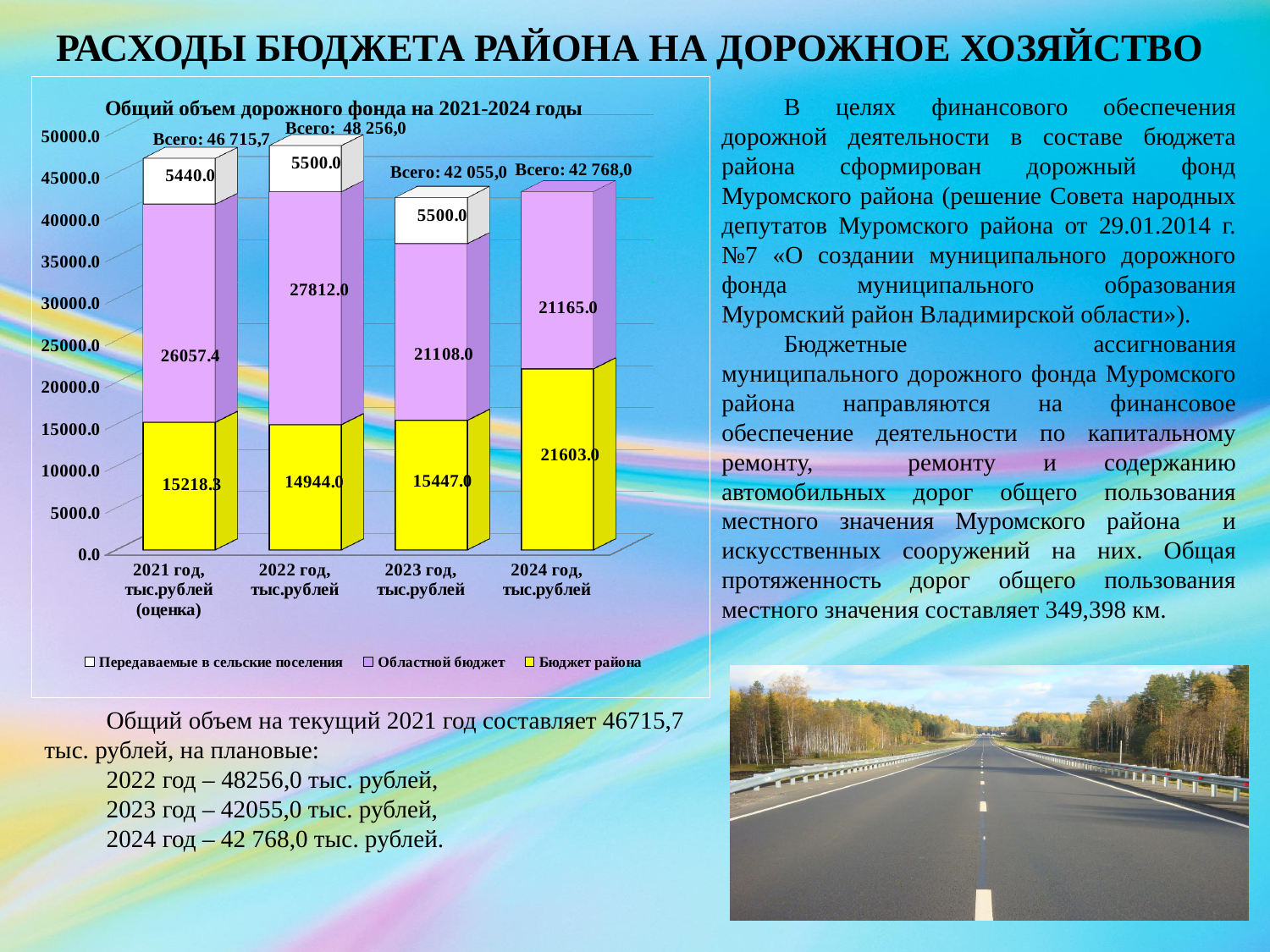
What is the title of the chart? Общий объем дорожного фонда на 2021-2024 годы What is the difference between 'Областной бюджет' in 2022 год and 2023 год? 6704.0 What is the value of 'Областной бюджет' for 2022 год? 27812.0 What is the value of 'Бюджет района' for 2024 год? 21603.0 What is the total ('Всего') for 2023 год? 42 055,0 How many series does the chart legend list? 3 Which is larger: 'Бюджет района' in 2024 год or 'Бюджет района' in 2021 год (оценка)? 2024 год Which year has the lowest total road fund volume? 2023 год What is the value of 'Передаваемые в сельские поселения' for 2021 год (оценка)? 5440.0 Which year has the highest total road fund volume? 2022 год How many year categories are shown on the x axis of the chart? 4 What type of chart is shown on the slide? Stacked bar chart